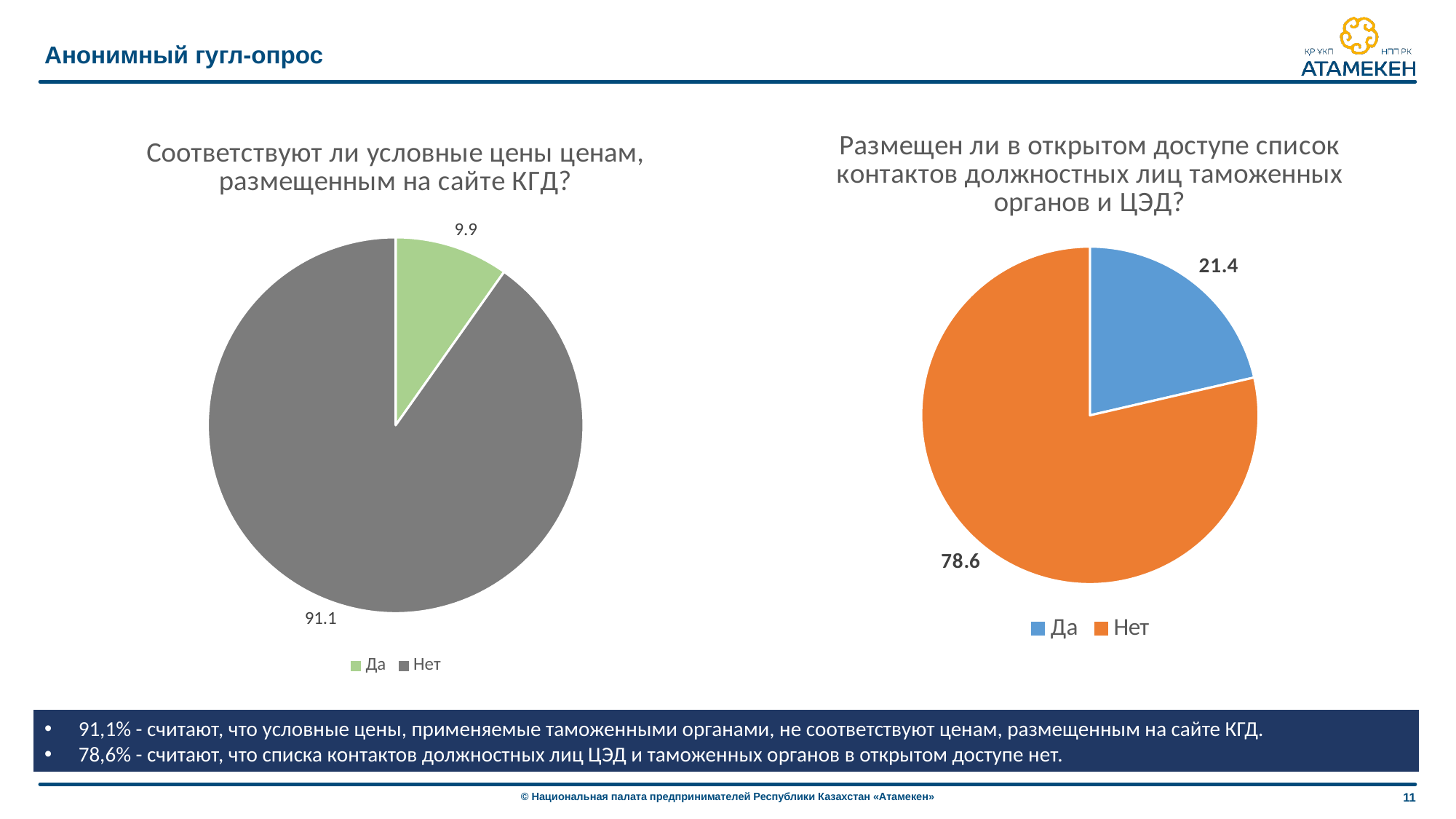
In the right pie chart, what colour is the "Нет" slice? Orange What type of chart is the left chart on the slide? Pie chart In the right pie chart, which category has the smallest slice? Да In the right pie chart, what is the difference between the values for "Нет" and "Да"? 57.2 In the left pie chart, what is the value for "Нет"? 91.1 In the left pie chart, which category has the largest slice? Нет How many categories does the right pie chart show? 2 In the right pie chart, what is the value for "Да"? 21.4 In the left pie chart, what is the difference between the values for "Нет" and "Да"? 81.2 In the left pie chart, what is the value for "Да"? 9.9 Which is larger: the "Да" value in the left pie chart or the "Да" value in the right pie chart? The right pie chart (21.4) In the right pie chart, what is the value for "Нет"? 78.6